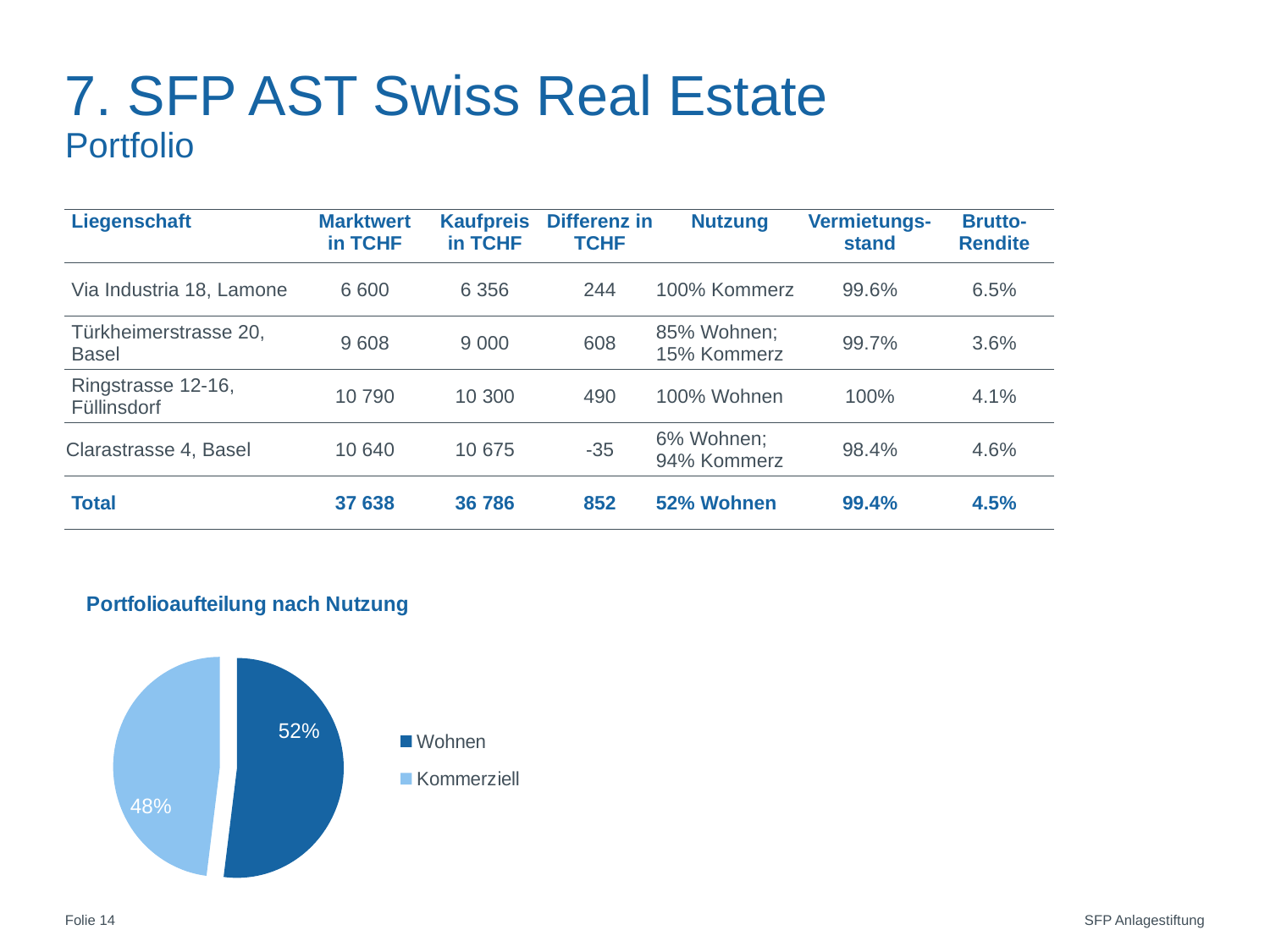
What is the difference in percentage points between the Wohnen and Kommerziell slices? 4 percentage points Is the Wohnen share in the pie chart greater or less than 50%? greater What share of the pie chart does Kommerziell have? 48% Which is larger in the pie chart, Wohnen or Kommerziell? Wohnen Which slice of the pie chart is the largest? Wohnen How many entries does the pie chart legend list? 2 Which slice of the pie chart is the smallest? Kommerziell What share of the pie chart does Wohnen have? 52% What kind of chart is shown under 'Portfolioaufteilung nach Nutzung'? pie chart Which legend entry is shown in the lighter blue colour in the pie chart? Kommerziell How many slices does the pie chart have? 2 What is the title of the pie chart? Portfolioaufteilung nach Nutzung